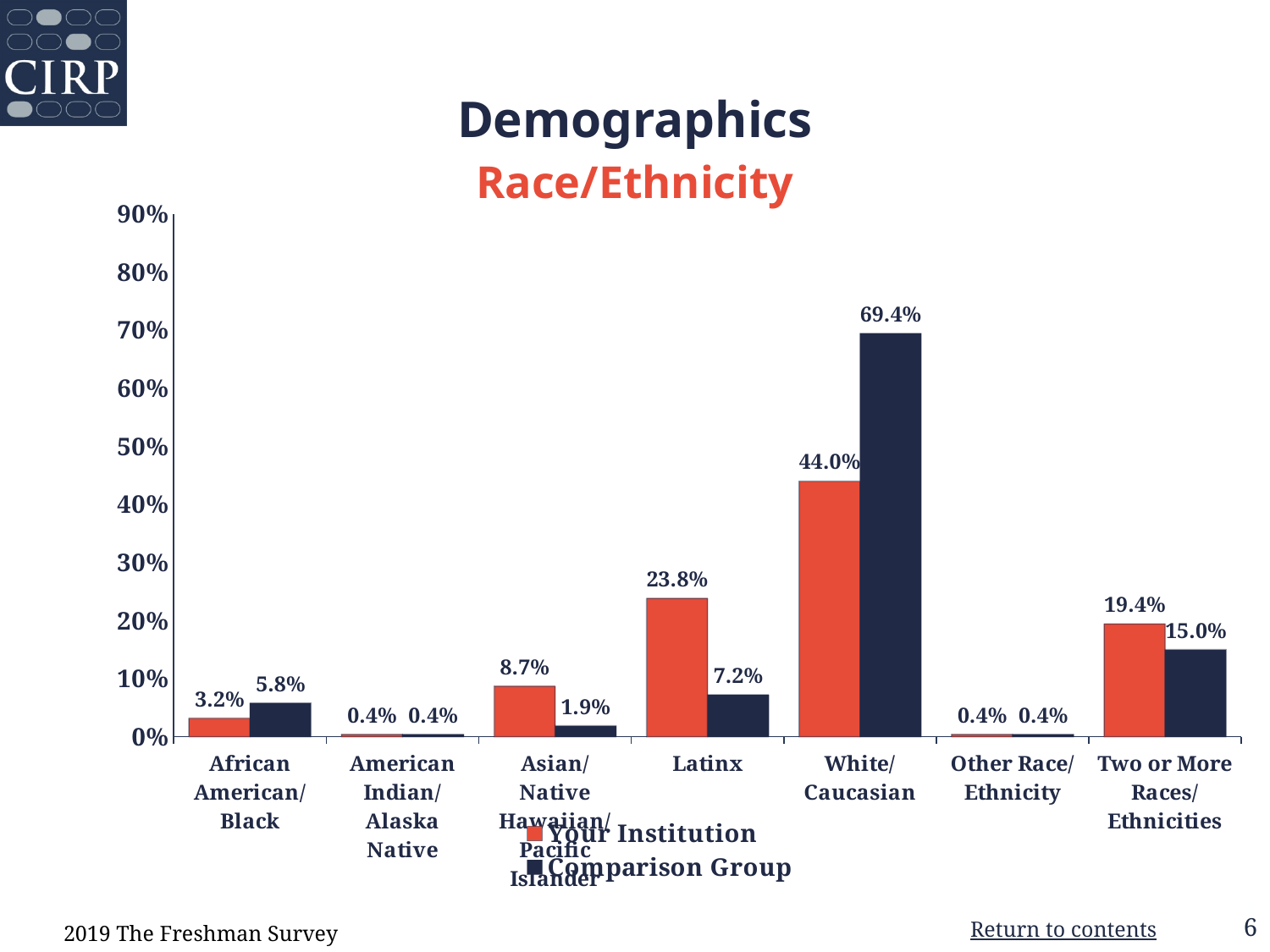
What is the difference between the Comparison Group and Your Institution values for White/Caucasian? 25.4% For Two or More Races/Ethnicities, which is larger: Your Institution or Comparison Group? Your Institution How many race/ethnicity categories are shown on the x axis? 7 What is the Your Institution value for Asian/Native Hawaiian/Pacific Islander? 8.7% What is the difference between the Your Institution and Comparison Group values for Latinx? 16.6% What is the Your Institution value for White/Caucasian? 44.0% Which category has the highest Comparison Group value? White/Caucasian Which category has the highest Your Institution value? White/Caucasian How many series does the legend list? 2 What kind of chart is shown on the slide? Bar chart For African American/Black, which is larger: Your Institution or Comparison Group? Comparison Group What is the Comparison Group value for Latinx? 7.2%